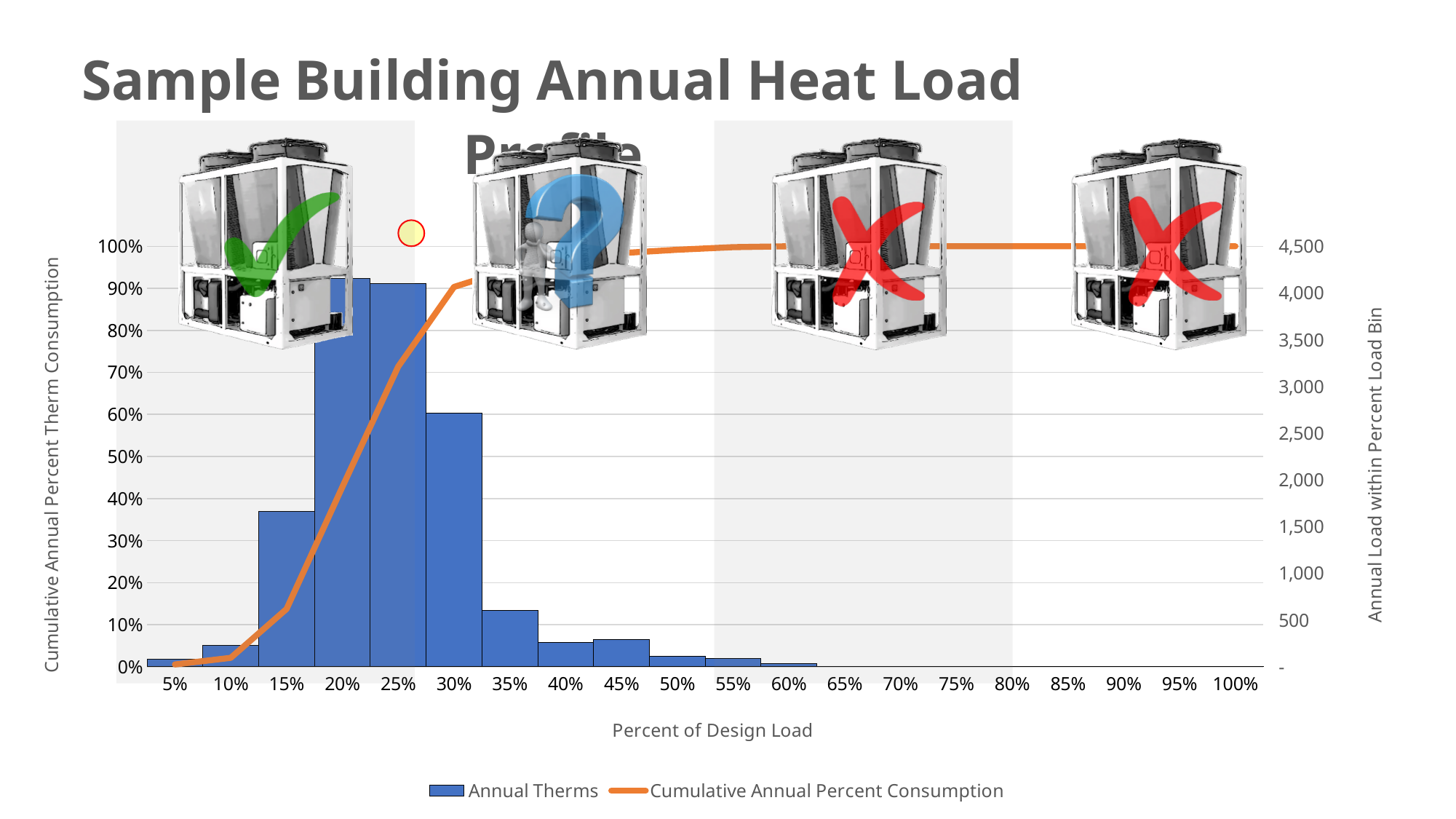
Which series is drawn as an orange line? Cumulative Annual Percent Consumption Which bin has the larger Annual Therms value, 15% or 30%? 30% Is the Annual Therms value for the 30% bin greater or less than 2,000? greater Is the Annual Therms value for the 20% bin greater or less than 4,000? greater Is the Annual Therms value for the 15% bin greater or less than 2,000? less Does the Cumulative Annual Percent Consumption line rise or fall as Percent of Design Load increases? Rises What is the title of the x axis? Percent of Design Load How many series does the legend list? 2 How many percent-of-design-load categories are shown on the x axis? 20 What kind of chart is shown on the slide? A combination bar and line chart